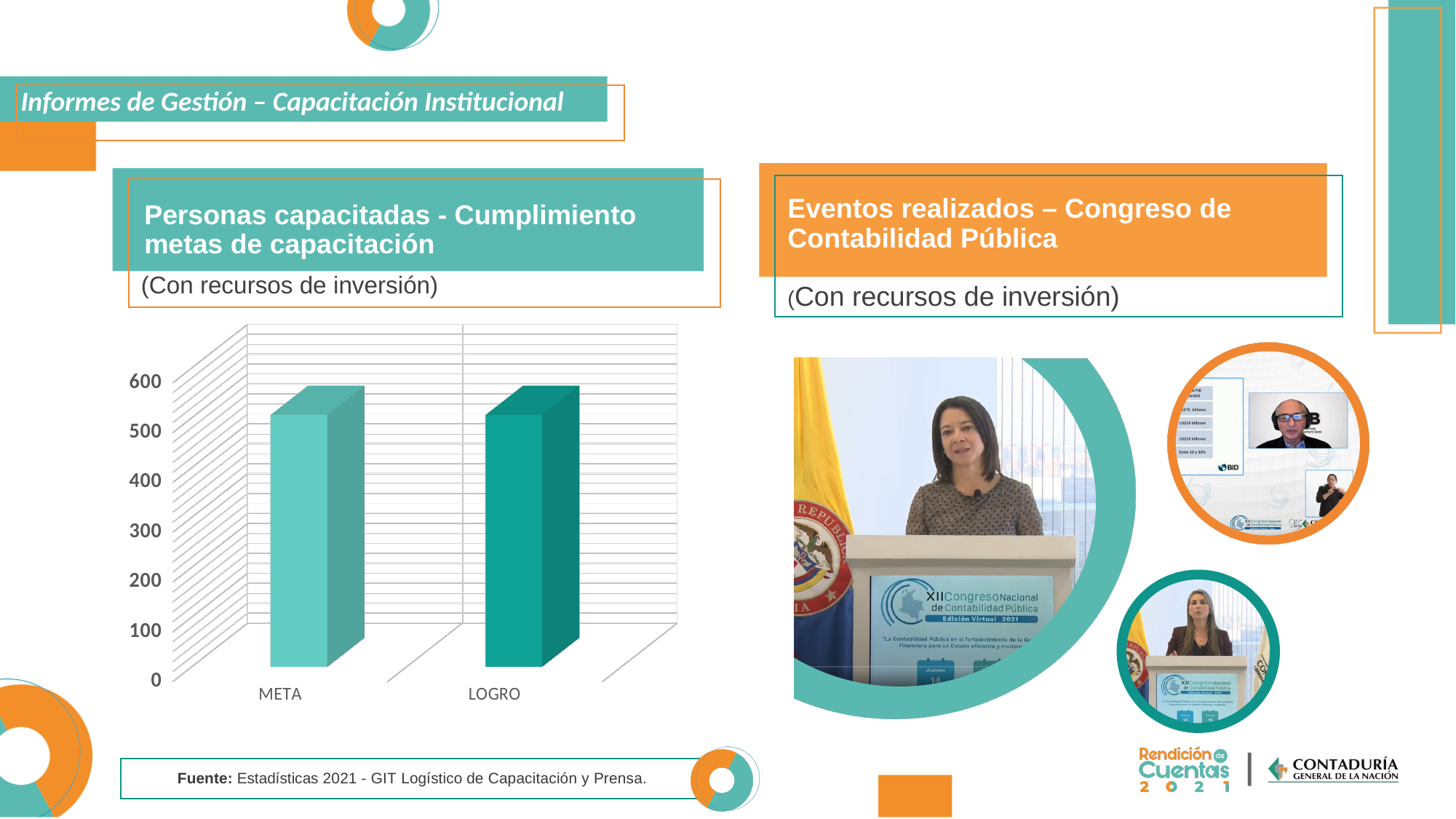
Is the value for LOGRO greater or less than 600? less Is the value for LOGRO greater or less than 300? greater How many categories are plotted in the bar chart? 2 What are the two categories shown on the x axis of the bar chart? META and LOGRO What kind of chart is shown under "Personas capacitadas - Cumplimiento metas de capacitación"? bar chart What is the highest tick label shown on the vertical axis of the bar chart? 600 Is the value for META greater or less than 600? less